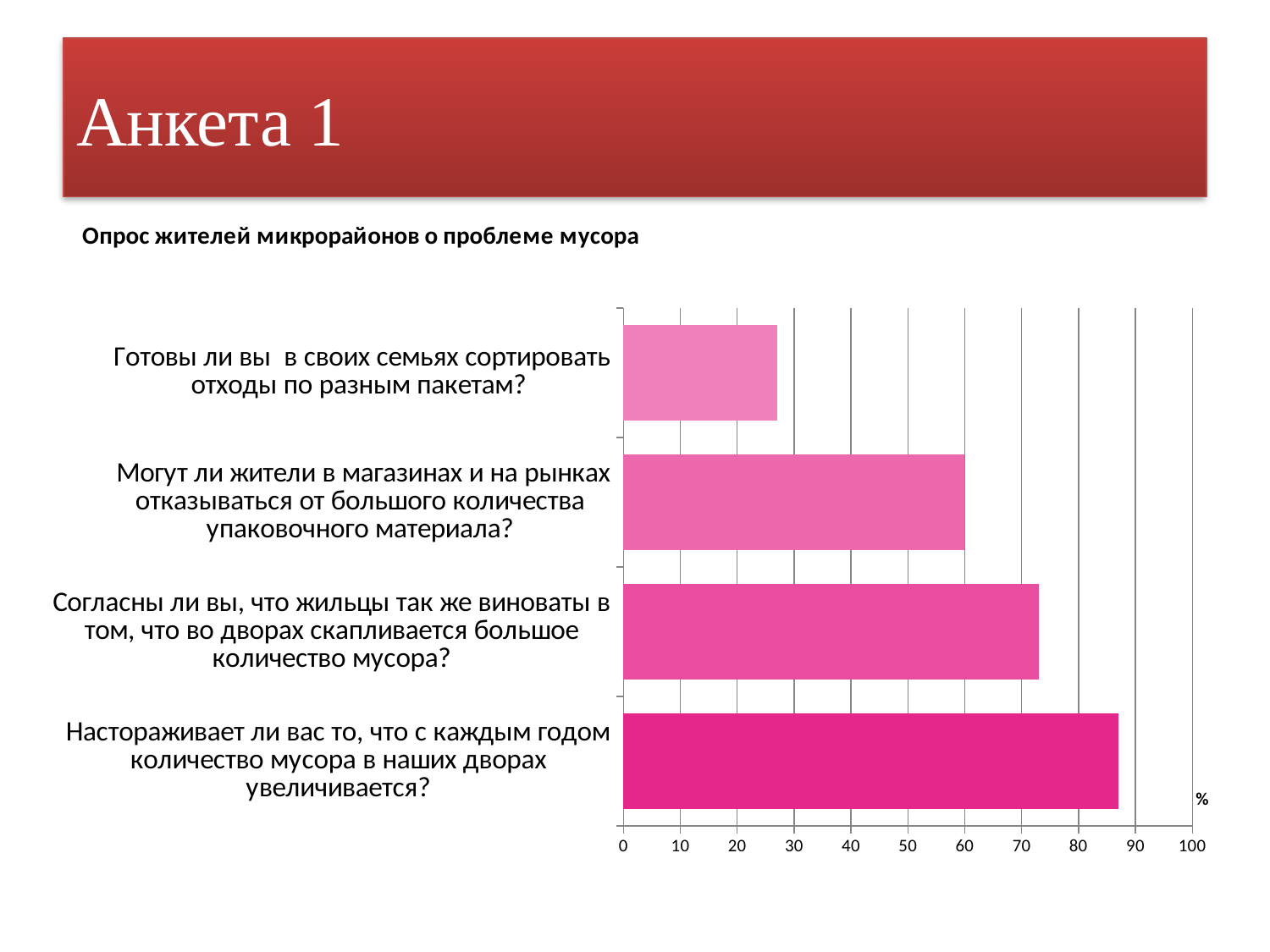
How many questions (categories) are plotted in the chart? 4 What is the maximum value shown on the horizontal axis? 100 Is the value for "Настораживает ли вас то, что с каждым годом количество мусора в наших дворах увеличивается?" greater or less than 80? greater Is the value for "Готовы ли вы в своих семьях сортировать отходы по разным пакетам?" greater or less than 30? less What kind of chart is shown on the slide? bar chart Is the value for "Могут ли жители в магазинах и на рынках отказываться от большого количества упаковочного материала?" greater or less than 50? greater Which has a larger value: "Согласны ли вы, что жильцы так же виноваты..." or "Могут ли жители в магазинах и на рынках отказываться..."? Согласны ли вы, что жильцы так же виноваты в том, что во дворах скапливается большое количество мусора? What is the subtitle text above the chart? Опрос жителей микрорайонов о проблеме мусора Which question has the lowest value in the chart? Готовы ли вы в своих семьях сортировать отходы по разным пакетам? Which question has the highest value in the chart? Настораживает ли вас то, что с каждым годом количество мусора в наших дворах увеличивается?